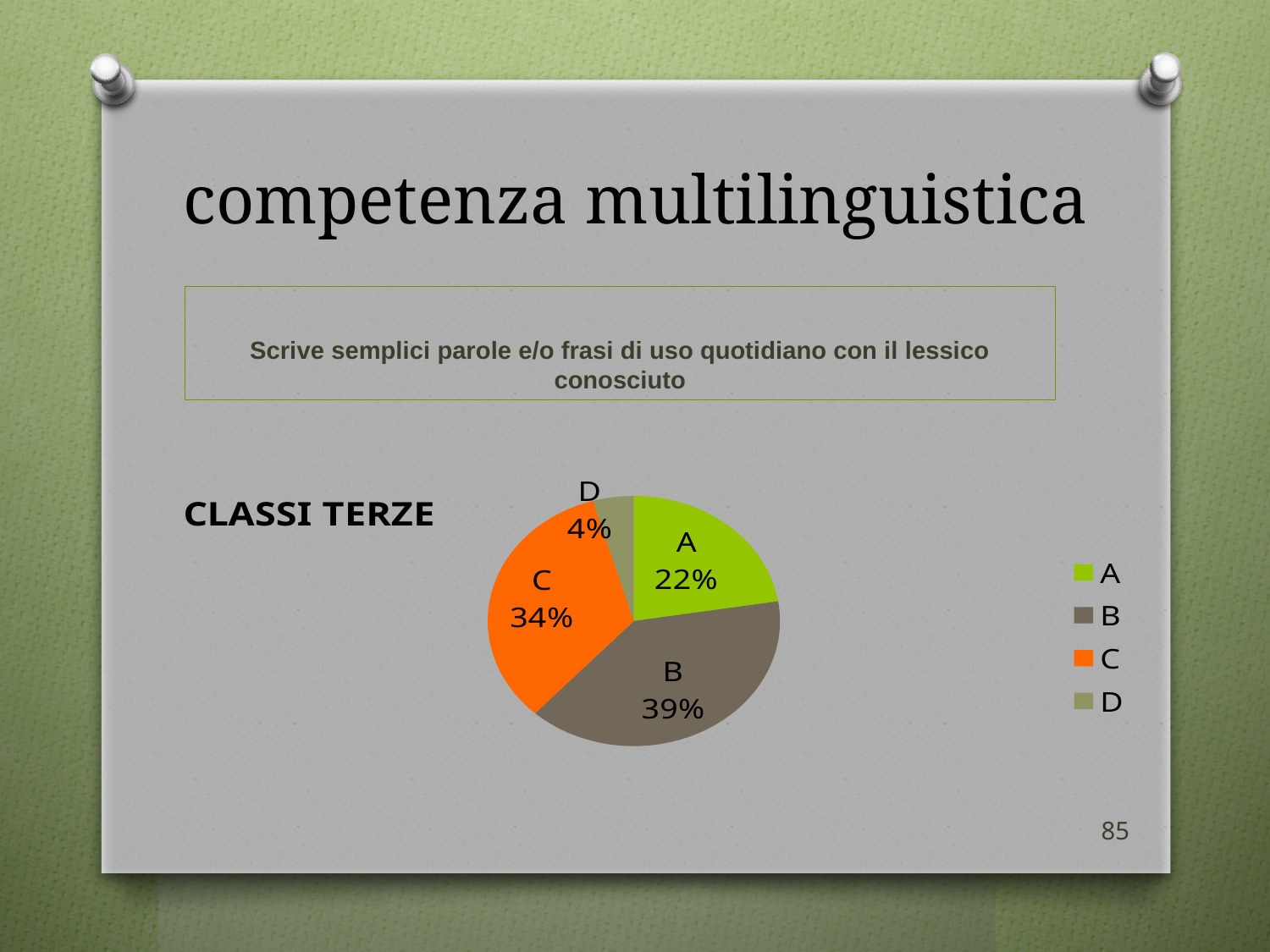
How many slices does the pie chart have? 4 What type of chart is shown on the slide? pie chart How many entries does the legend list? 4 What percentage does slice B represent? 39% Which category has the smallest share of the pie? D Which is larger, the share for A or the share for C? C What colour is the slice for C in the pie chart? orange Which category has the largest share of the pie? B What percentage does slice D represent? 4% What is the difference in percentage points between B and C? 5 What percentage does slice A represent? 22% What percentage does slice C represent? 34%